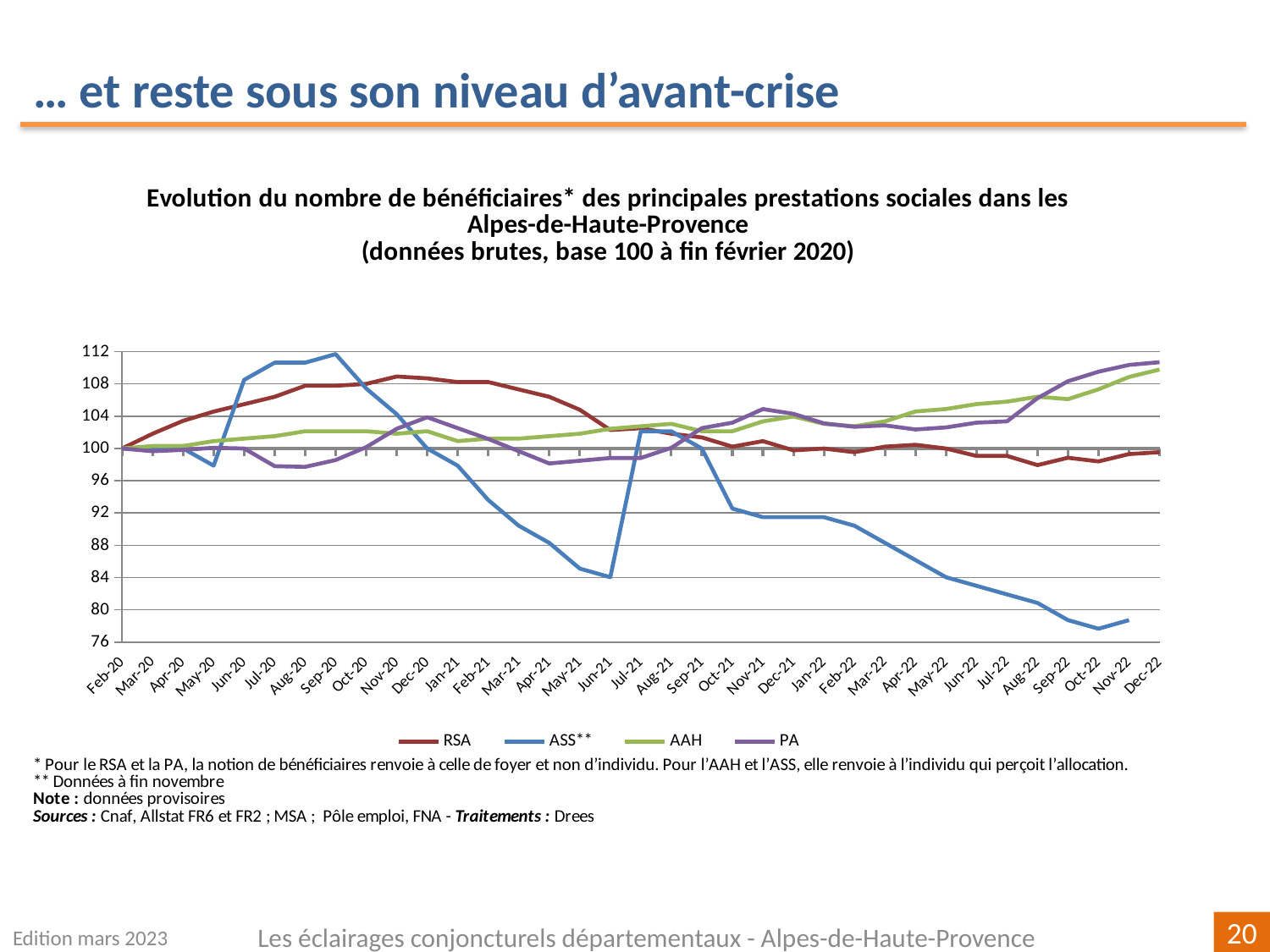
Does the ASS** series rise or fall between Sep-21 and Nov-22? fall What kind of chart is shown on the slide? line chart What is the base period of the index (base 100) according to the chart title? fin février 2020 Which series has the highest value in Sep-20? ASS** Is the value for ASS** in Sep-20 greater or less than 108? greater Is the value for RSA in Aug-22 greater or less than 100? less Is the value for ASS** in Nov-22 greater or less than 80? less How many series does the legend list? 4 Which series has the lowest value in Nov-22? ASS** Which series are listed in the legend? RSA, ASS**, AAH, PA